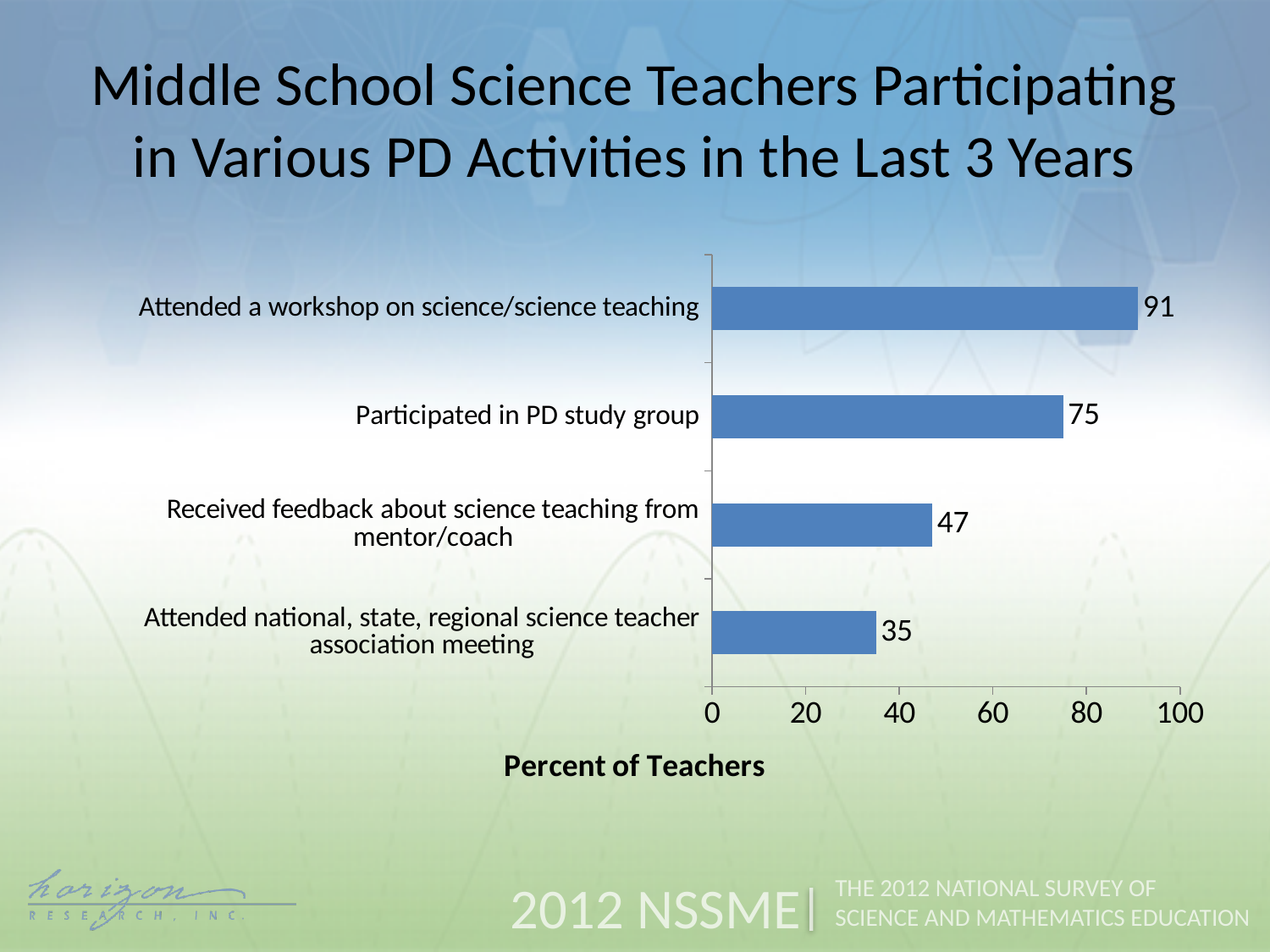
What is the label of the horizontal axis? Percent of Teachers What kind of chart is shown on the slide? Bar chart What percent of teachers participated in a PD study group? 75 What is the difference in percent between attending a workshop and participating in a PD study group? 16 How many PD activities are shown in the chart? 4 Which PD activity has the lowest percent of teachers participating? Attended national, state, regional science teacher association meeting What percent of teachers attended a national, state, or regional science teacher association meeting? 35 Which PD activity has the highest percent of teachers participating? Attended a workshop on science/science teaching What percent of middle school science teachers attended a workshop on science/science teaching? 91 What percent of teachers received feedback about science teaching from a mentor/coach? 47 What is the difference in percent between receiving feedback from a mentor/coach and attending a science teacher association meeting? 12 Which is larger: the percent who participated in a PD study group or the percent who received feedback from a mentor/coach? Participated in PD study group